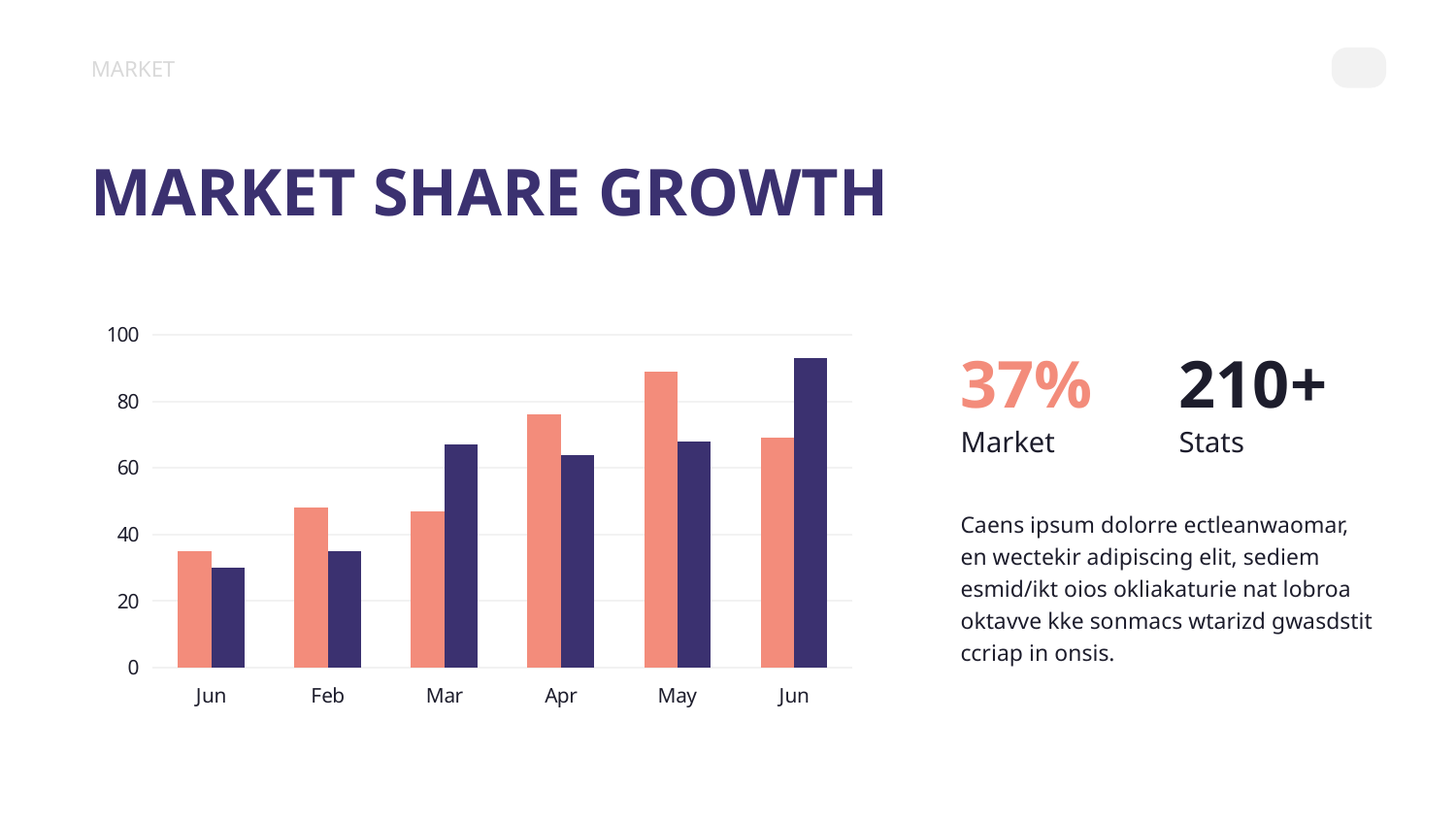
Which category has the tallest dark purple bar? Jun (far right) Is the dark purple bar for Mar greater or less than 60? greater What is the title of the chart on the slide? MARKET SHARE GROWTH Is the salmon-coloured bar for Feb greater or less than 40? greater For Mar, which bar is taller: the salmon-coloured bar or the dark purple bar? Dark purple For Apr, which bar is taller: the salmon-coloured bar or the dark purple bar? Salmon What kind of chart is shown on the slide? Bar chart Is the dark purple bar for the first category (Jun, far left) greater or less than 40? less How many categories are shown along the x axis of the chart? 6 Which category has the tallest salmon-coloured bar? May How many bar series (colours) are plotted in the chart? 2